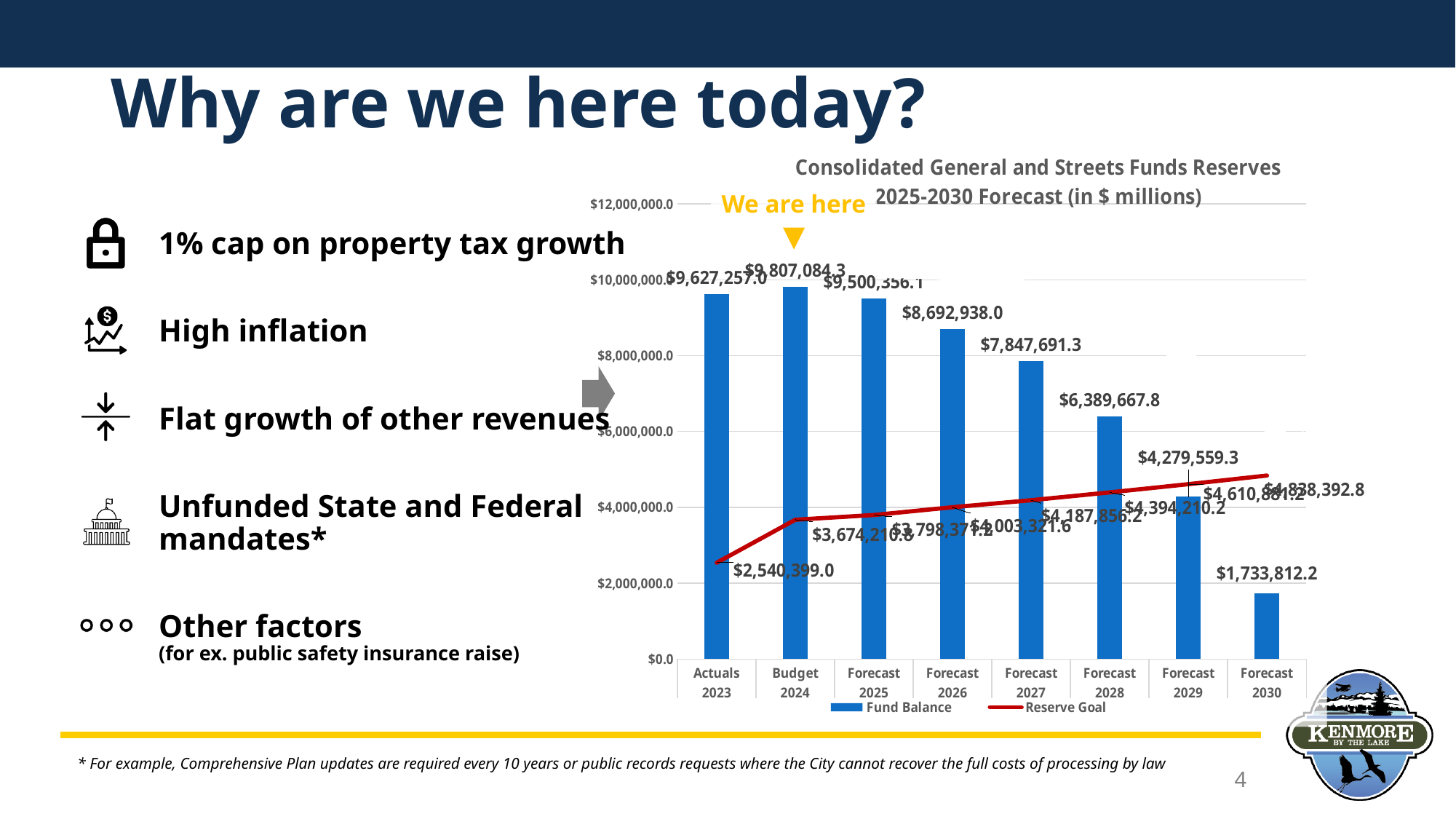
Which category has the lowest Fund Balance? Forecast 2030 Is the Fund Balance for Forecast 2029 greater or less than $6,000,000.0? less What is the Fund Balance value for Forecast 2026? $8,692,938.0 How many series does the chart legend list? 2 What is the difference between the Fund Balance for Budget 2024 and Actuals 2023? $179,827.3 What is the Reserve Goal value for Actuals 2023? $2,540,399.0 What is the Fund Balance value for Forecast 2030? $1,733,812.2 What is the difference between the Fund Balance for Forecast 2029 and Forecast 2030? $2,545,747.1 Which has a larger Fund Balance, Forecast 2027 or Forecast 2028? Forecast 2027 How many categories are shown on the x axis of the chart? 8 Which category has the highest Fund Balance? Budget 2024 Does the Fund Balance rise or fall from Forecast 2025 to Forecast 2030? fall